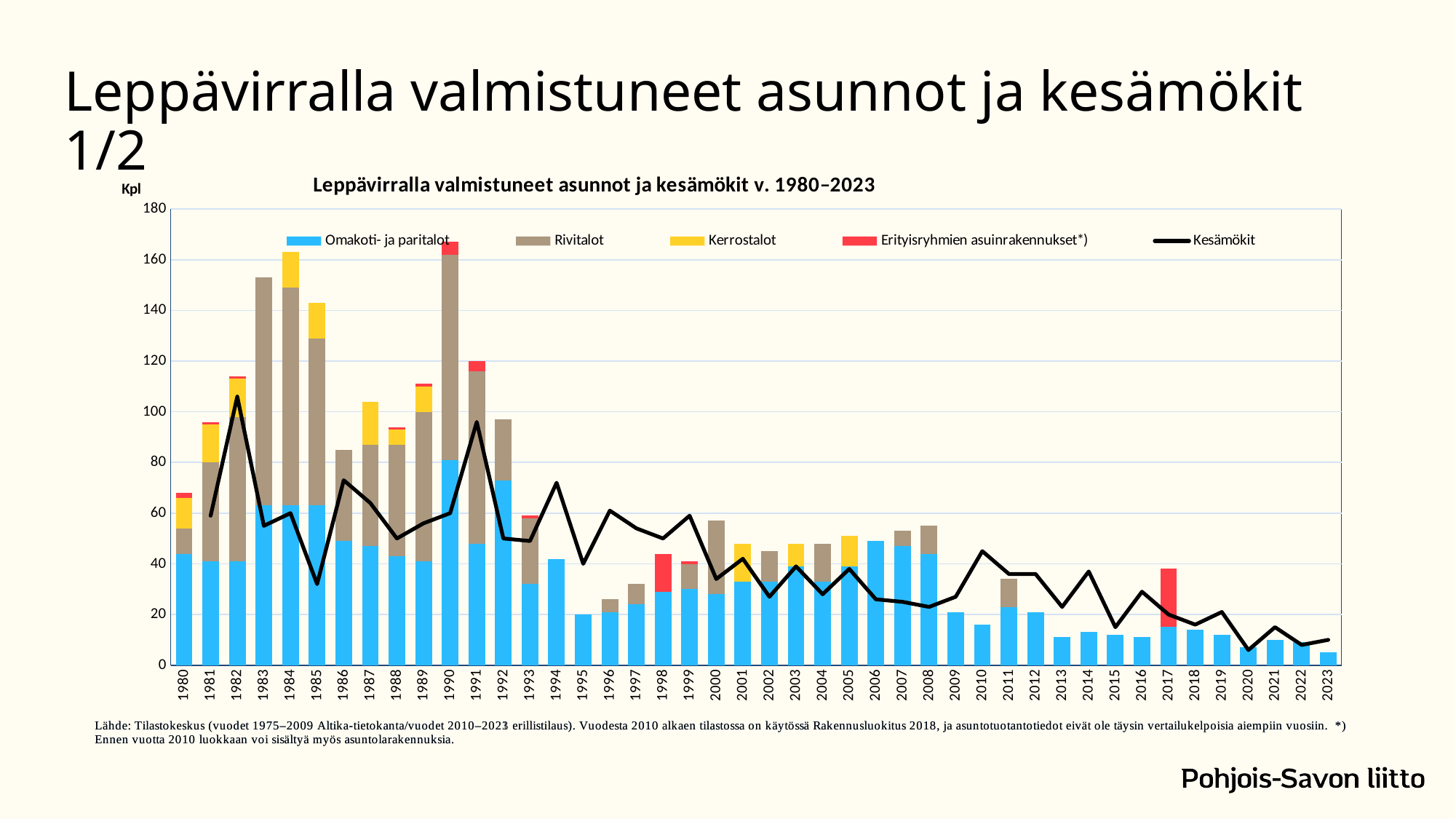
In which year does the Kesämökit line reach its highest point? 1982 What kind of chart is shown on the slide? A stacked bar chart combined with a line Is the Kesämökit value for 1982 greater or less than 100? greater Does the Kesämökit line overall rise or fall from 1980 to 2023? fall How many years are shown on the x axis? 44 Which year has the taller stacked bar, 1983 or 1985? 1983 Which year has the tallest stacked bar? 1990 Is the Kesämökit value for 1985 greater or less than 40? less Is the total stacked bar for 1990 greater or less than 160? greater Which year has the shortest stacked bar? 2023 What unit label is shown at the top of the y axis? Kpl How many series does the legend list? 5